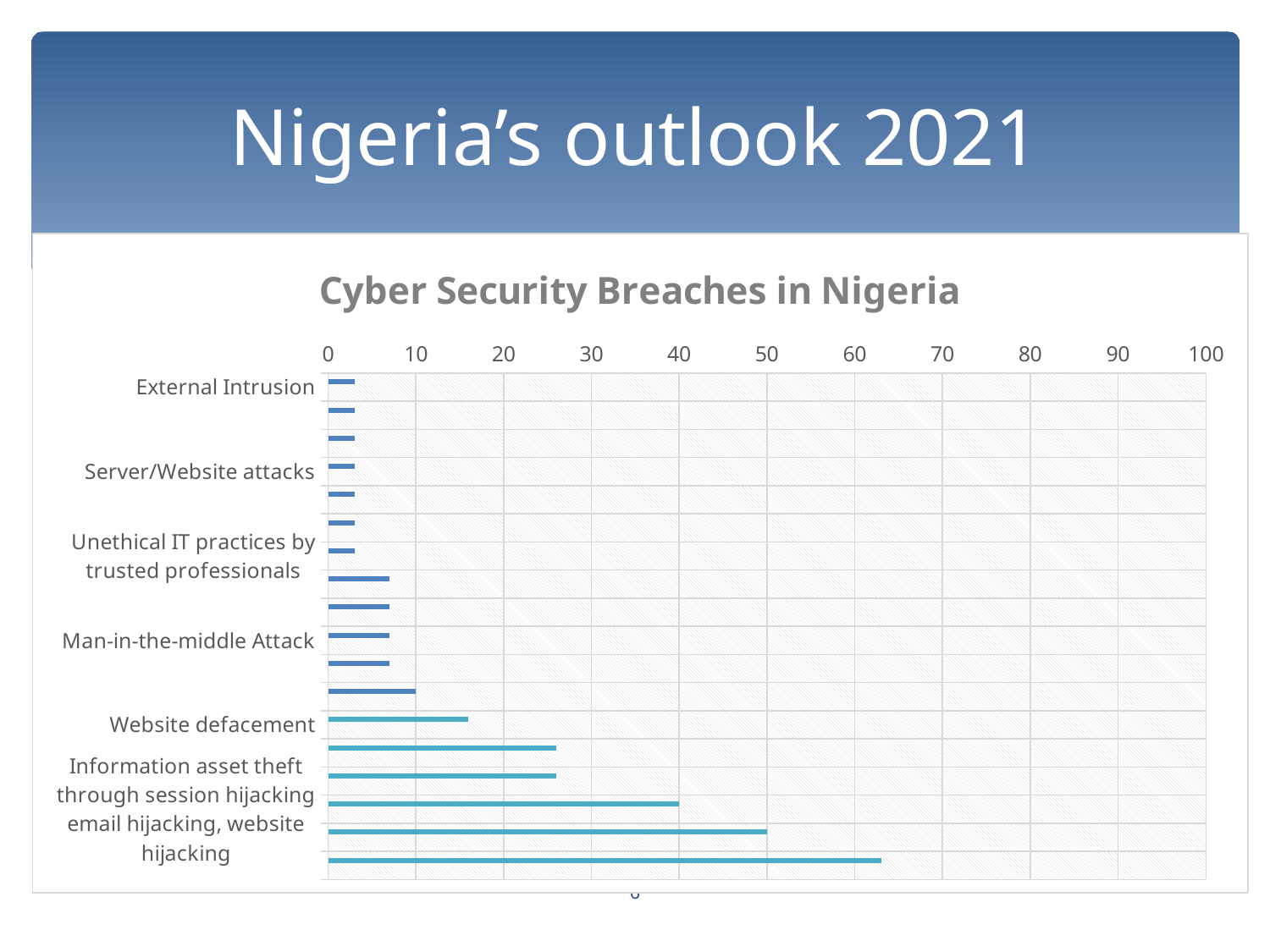
What is the highest value shown on the horizontal axis? 100 Is the value for Information asset theft through session hijacking, email hijacking, website hijacking greater or less than 20? greater Is the value for Website defacement greater or less than 20? less Which has the larger value, Information asset theft through session hijacking, email hijacking, website hijacking or Man-in-the-middle Attack? Information asset theft through session hijacking, email hijacking, website hijacking Moving from the top of the chart to the bottom, do the bars generally get longer or shorter? longer What kind of chart is shown on the slide? bar chart Is the value for Server/Website attacks greater or less than 10? less Which has the larger value, Website defacement or External Intrusion? Website defacement What is the title of the chart? Cyber Security Breaches in Nigeria